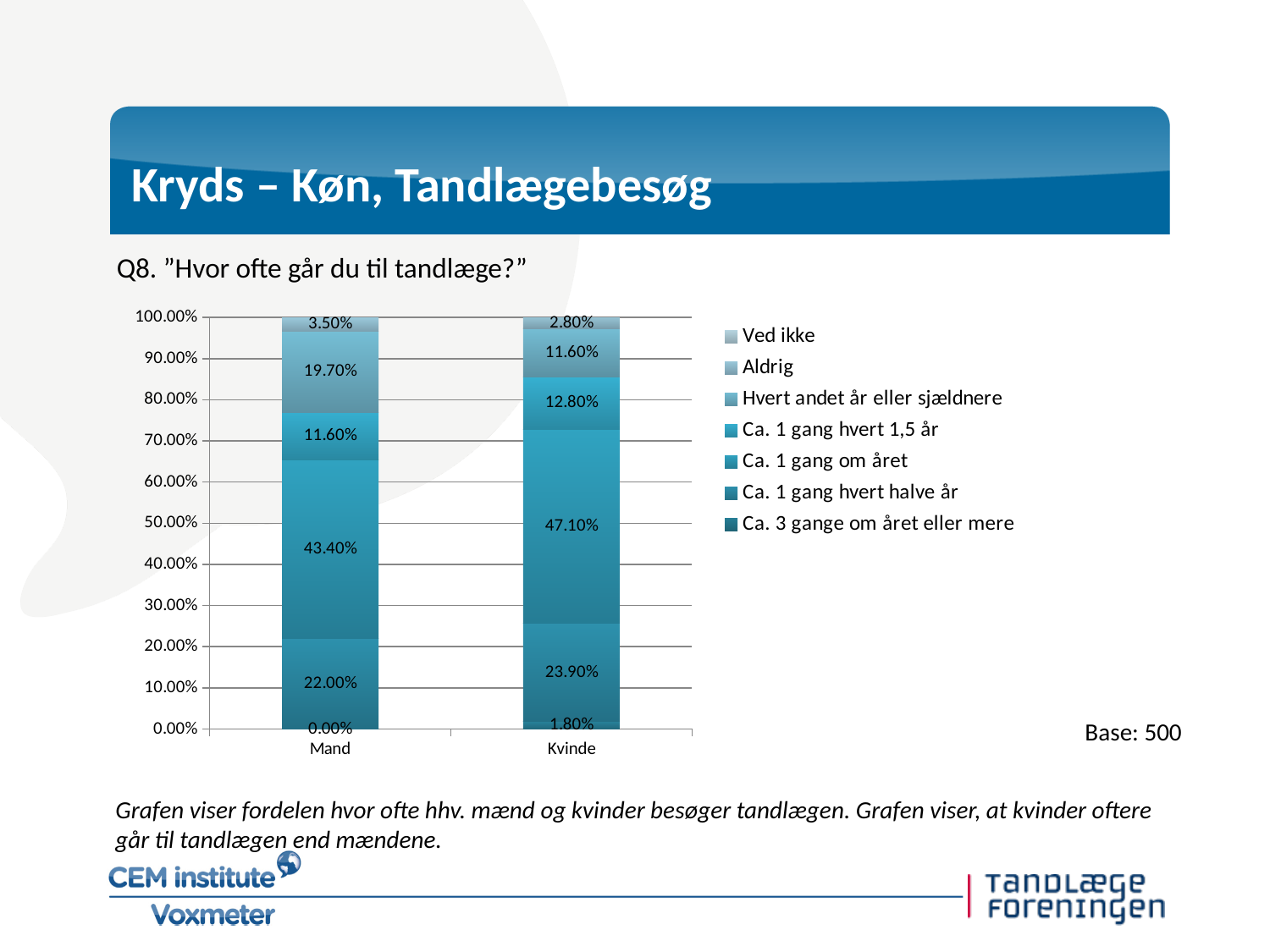
How many series does the chart's legend list? 7 What is the value of the largest segment in the Kvinde bar? 47.10% What is the value of the topmost segment in the Mand bar? 3.50% What is the value of the largest segment in the Mand bar? 43.40% What kind of chart is shown on the slide? Stacked bar chart What survey question is the chart based on? Q8. "Hvor ofte går du til tandlæge?" What is the base (number of respondents) stated on the slide? Base: 500 What is the difference between the second-from-bottom segment of the Kvinde bar (23.90%) and that of the Mand bar (22.00%)? 1.90 percentage points What is the difference between the largest segment of the Kvinde bar (47.10%) and the largest segment of the Mand bar (43.40%)? 3.70 percentage points Which bar has the larger largest segment, Mand or Kvinde? Kvinde What is the value of the bottom segment in the Kvinde bar? 1.80% How many categories are shown on the x axis of the chart? 2